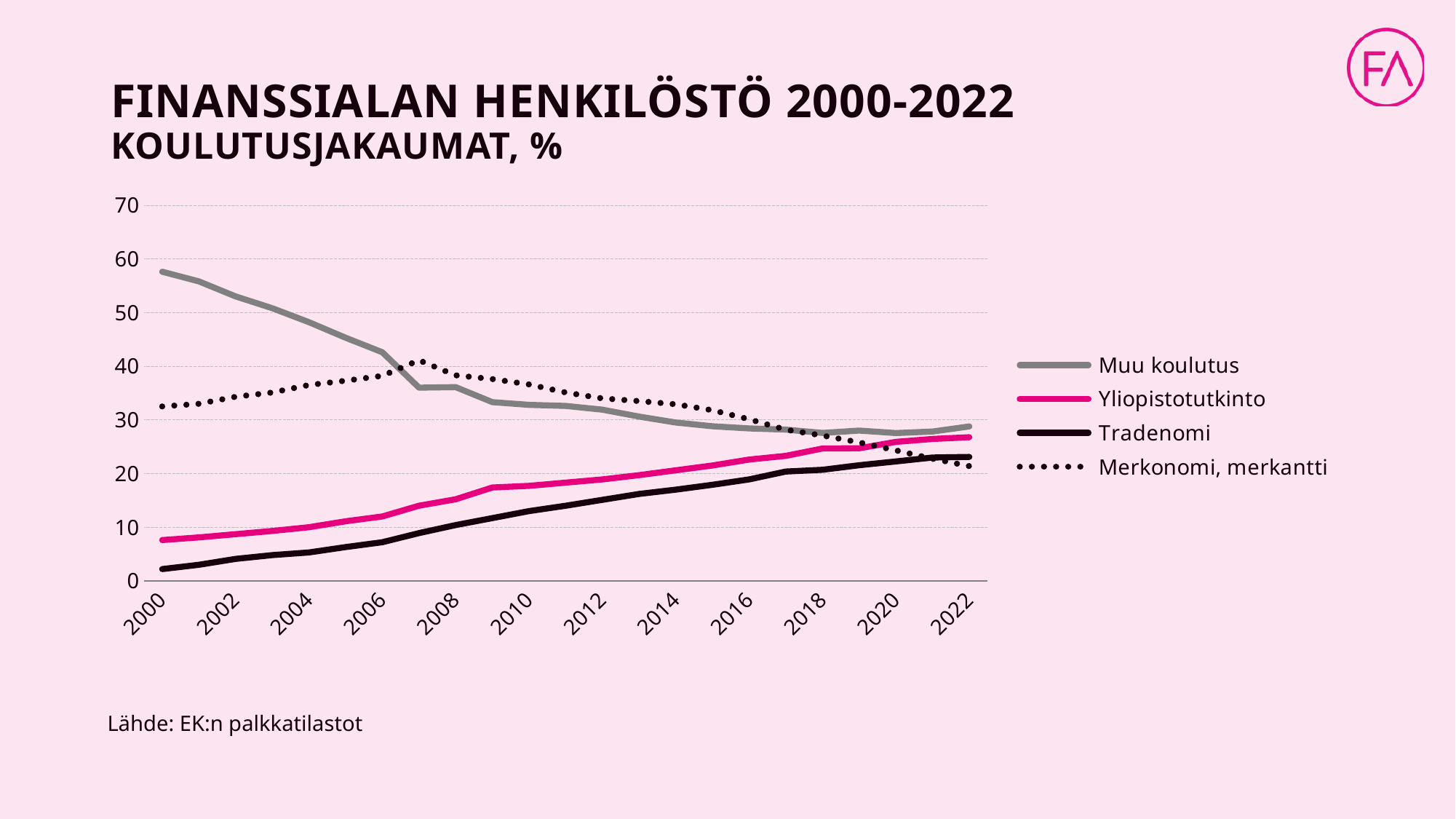
Is the value for Tradenomi in 2000 greater or less than 10? less Which series is drawn with a dotted line? Merkonomi, merkantti Is the value for Muu koulutus in 2000 greater or less than 50? greater Is the value for Merkonomi, merkantti in 2022 greater or less than 30? less Does the value for Muu koulutus rise or fall from 2000 to 2022? fall Which series has the highest value in 2000? Muu koulutus Does the value for Yliopistotutkinto rise or fall from 2000 to 2022? rise What kind of chart is shown on the slide? line chart In 2022, which is larger: Yliopistotutkinto or Tradenomi? Yliopistotutkinto Which series has the lowest value in 2000? Tradenomi How many series does the legend list? 4